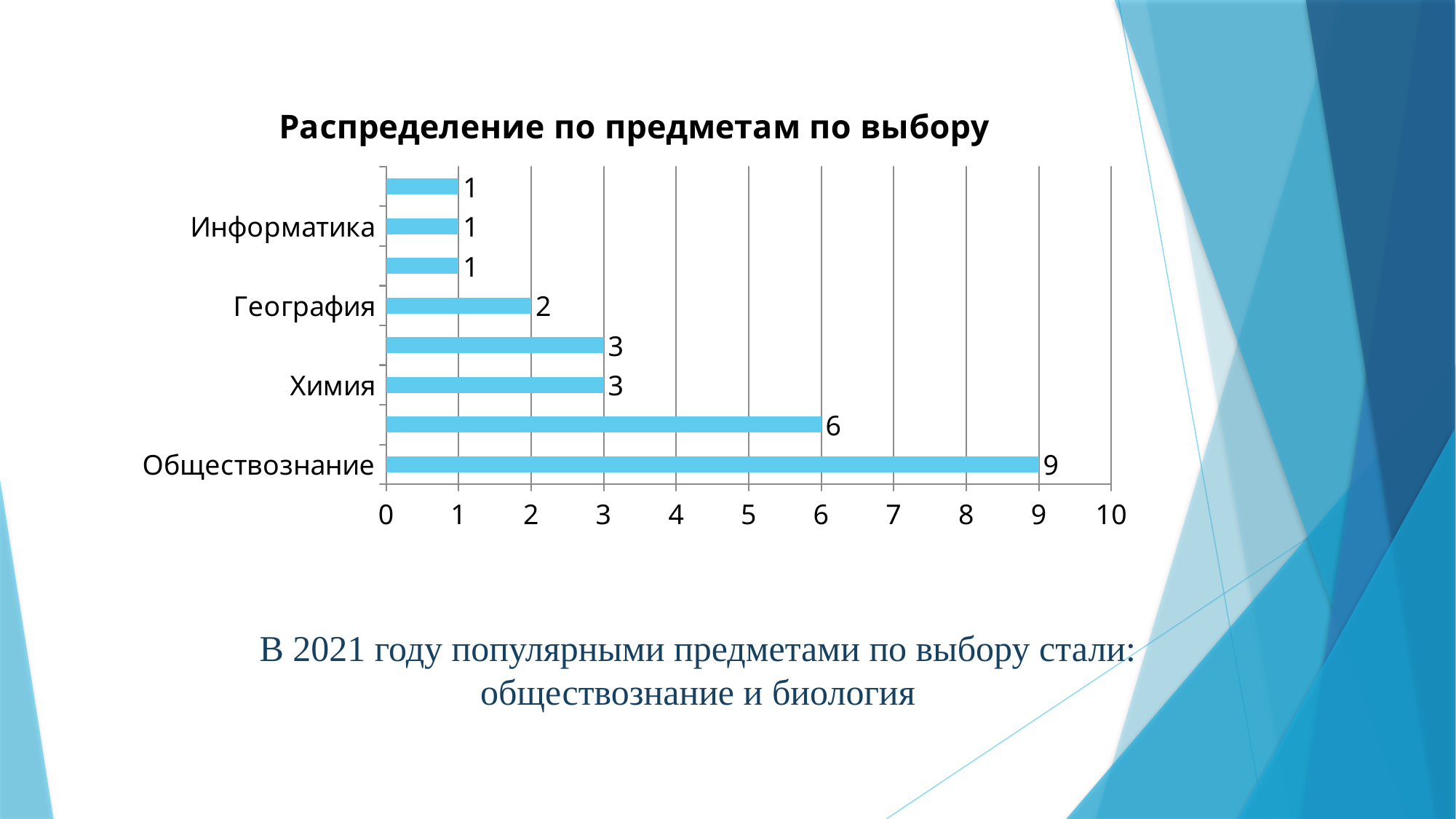
Which is larger, the value for Химия or the value for География? Химия What is the value for Обществознание? 9 What is the difference between the values for Обществознание and Химия? 6 What is the value for География? 2 What is the value for Химия? 3 What kind of chart is shown on the slide? bar chart What is the title of the chart? Распределение по предметам по выбору Which category has the highest value? Обществознание Is the value for Обществознание greater or less than 5? greater What is the value for Информатика? 1 What is the difference between the values for Обществознание and География? 7 How many bars are plotted in the chart? 8